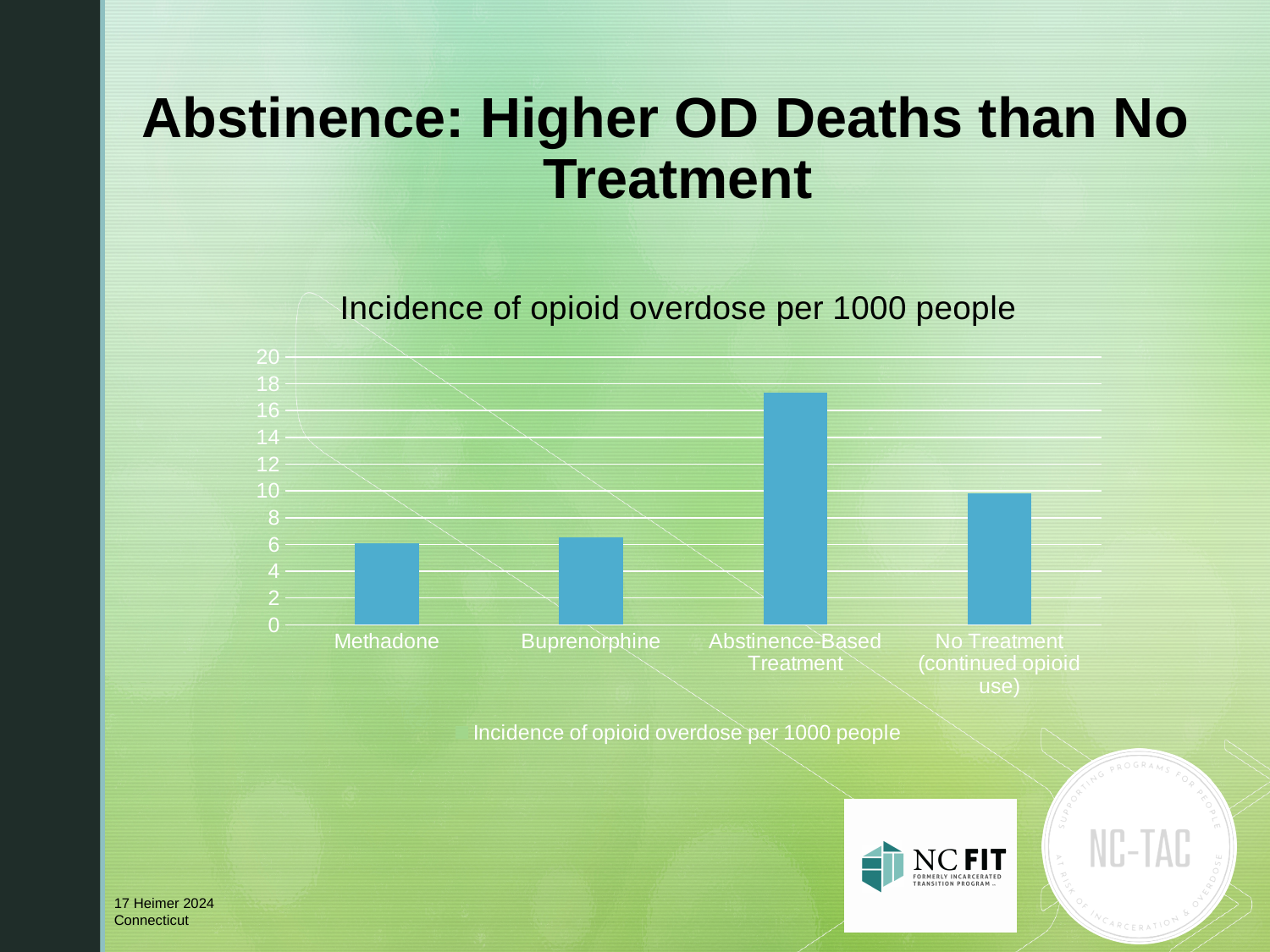
Is the value for Abstinence-Based Treatment greater or less than 18? less Is the value for Methadone greater or less than 8? less Is the value for No Treatment (continued opioid use) greater or less than 8? greater Which has a higher incidence of opioid overdose: Abstinence-Based Treatment or No Treatment (continued opioid use)? Abstinence-Based Treatment How many categories are shown on the x axis of the chart? 4 Which has a higher incidence of opioid overdose: Methadone or No Treatment (continued opioid use)? No Treatment (continued opioid use) How many series does the chart's legend list? 1 What kind of chart is shown on the slide? bar chart What is the title of the chart? Incidence of opioid overdose per 1000 people Which category has the highest incidence of opioid overdose per 1000 people? Abstinence-Based Treatment